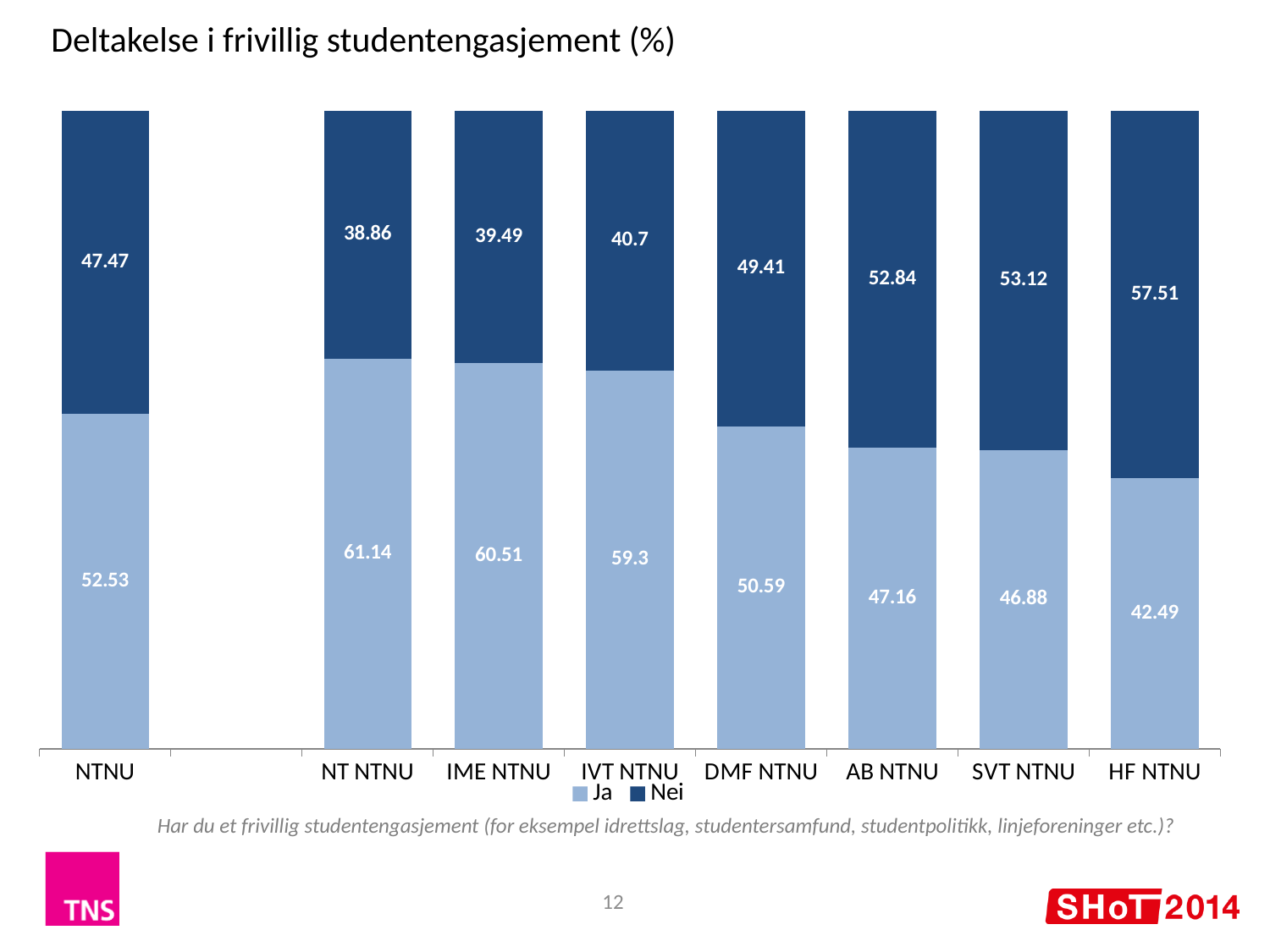
How many categories are shown on the x axis? 8 What is the 'Ja' value for NT NTNU? 61.14 Which category has the highest 'Ja' value? NT NTNU What kind of chart is shown on the slide? Stacked bar chart What is the title of the chart? Deltakelse i frivillig studentengasjement (%) Which category has the lowest 'Ja' value? HF NTNU What is the 'Ja' value for DMF NTNU? 50.59 What is the 'Nei' value for HF NTNU? 57.51 What is the total of the stacked bar for NTNU? 100 Which is larger, the 'Nei' value for AB NTNU or the 'Nei' value for IVT NTNU? AB NTNU How many series does the legend list? 2 What is the difference between the 'Ja' values for NT NTNU and HF NTNU? 18.65